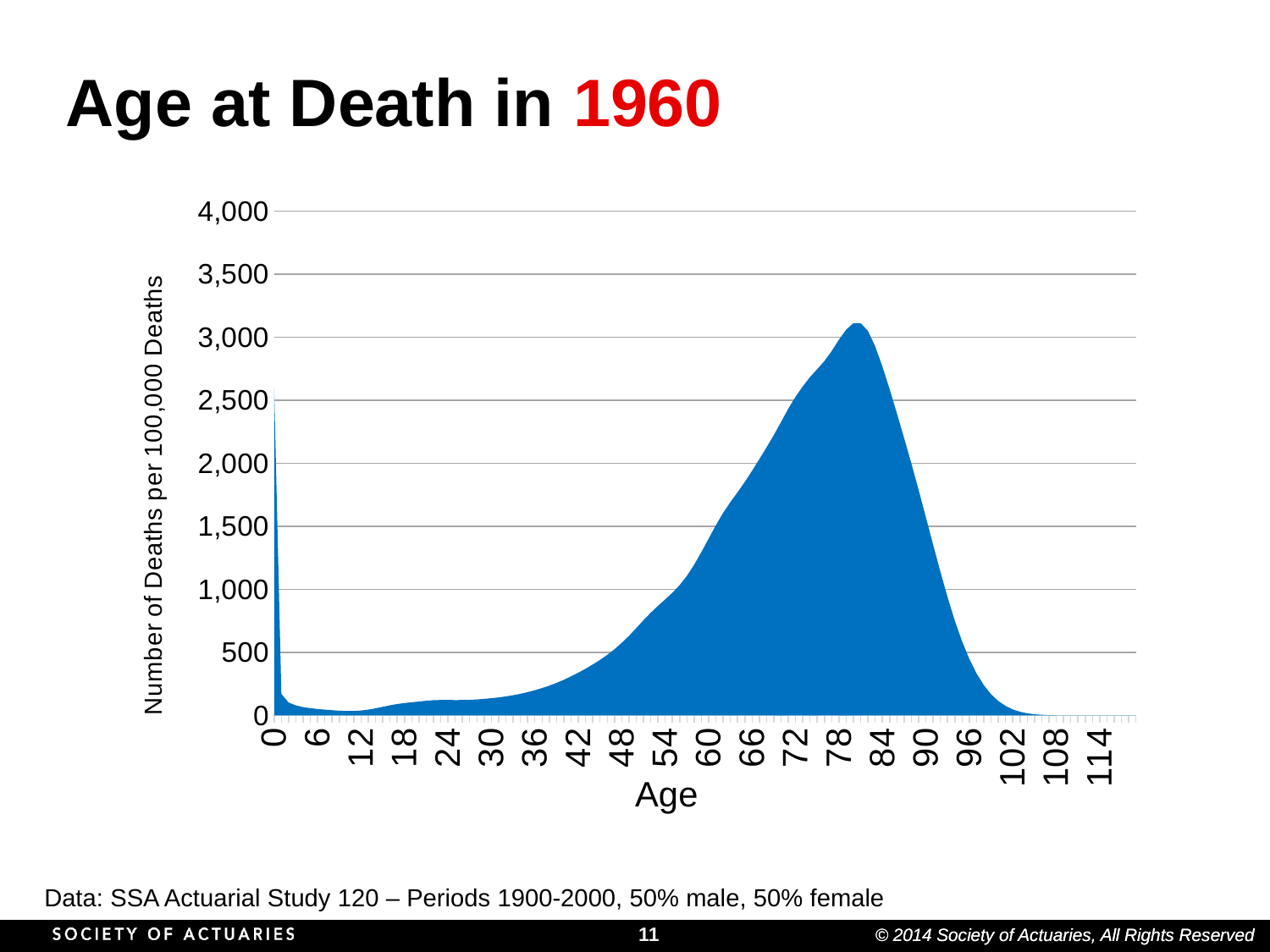
Is the value at age 102 greater or less than 500? less Is the peak value of the chart greater or less than 3,500? less Is the value at age 30 greater or less than 500? less Between ages 84 and 102, do the values rise or fall? fall What kind of chart is shown on the slide? Area chart Between ages 48 and 78, do the values rise or fall? rise What is the label of the vertical axis? Number of Deaths per 100,000 Deaths What is the title of the chart on the slide? Age at Death in 1960